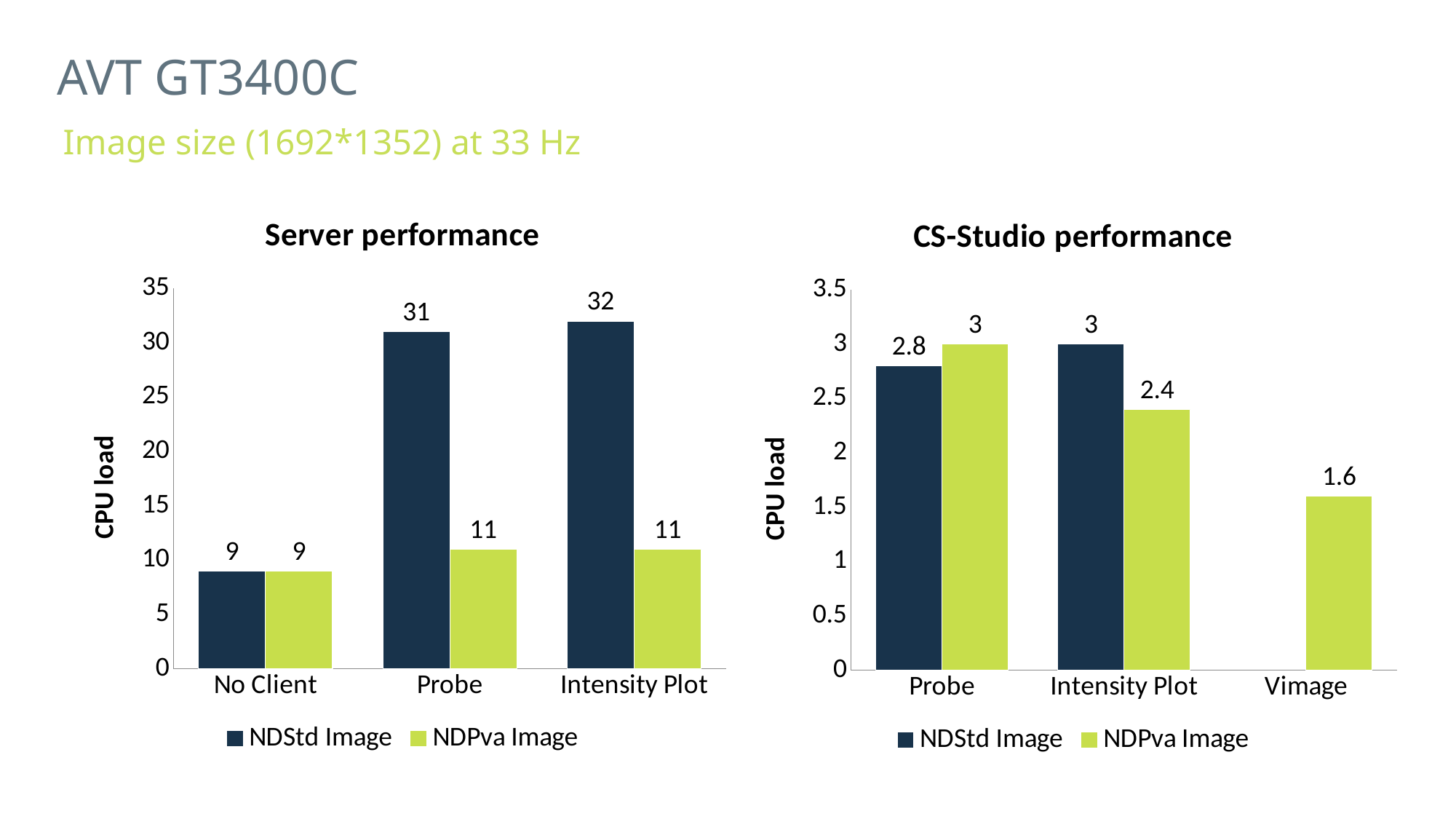
In the Server performance chart, what is the CPU load for NDPva Image at Intensity Plot? 11 In the CS-Studio performance chart, what is the difference between the NDStd Image and NDPva Image values at Intensity Plot? 0.6 How many series does the legend of the CS-Studio performance chart list? 2 In the Server performance chart, which category has the highest NDStd Image value? Intensity Plot In the Server performance chart, is the NDStd Image value at Intensity Plot greater or less than 30? greater In the Server performance chart, what is the CPU load for NDStd Image at Probe? 31 In the CS-Studio performance chart, what is the CPU load for NDStd Image at Probe? 2.8 In the Server performance chart, how many categories are shown on the x axis? 3 In the CS-Studio performance chart, which is larger at Intensity Plot: NDStd Image or NDPva Image? NDStd Image In the CS-Studio performance chart, what is the CPU load for NDPva Image at Vimage? 1.6 In the Server performance chart, what is the difference between the NDStd Image and NDPva Image values at Probe? 20 What kind of chart is the Server performance chart? Bar chart